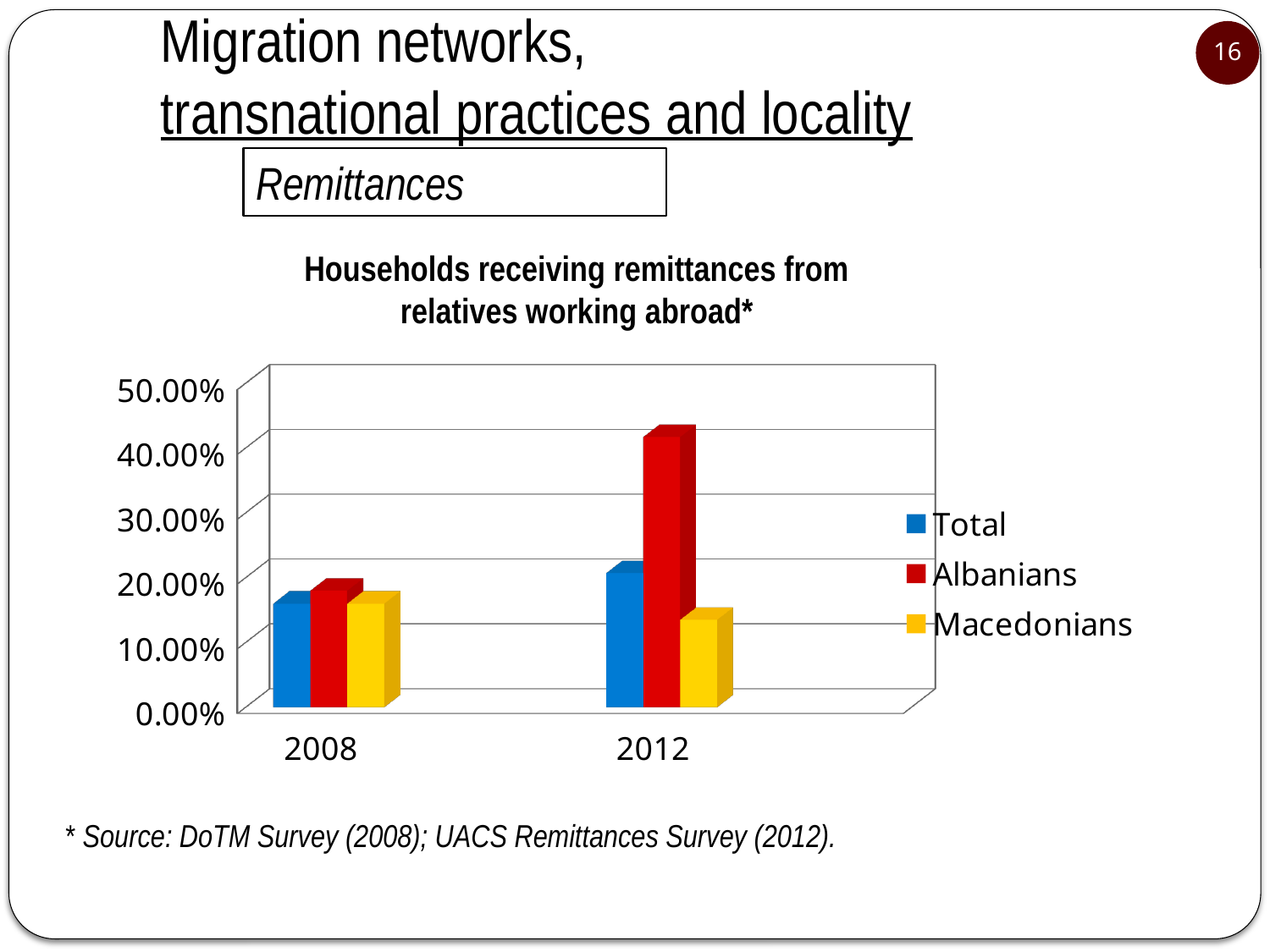
Does the value for Total rise or fall from 2008 to 2012? rise How many series does the legend list? 3 Is the value for Macedonians in 2012 greater or less than 20.00%? less Which series has the highest value in 2012? Albanians Is the value for Total in 2008 greater or less than 20.00%? less How many year categories are shown on the x axis? 2 What is the title of the chart? Households receiving remittances from relatives working abroad* Which is larger: the value for Albanians in 2008 or in 2012? 2012 Is the value for Albanians in 2008 greater or less than 30.00%? less Which series has the lowest value in 2012? Macedonians What kind of chart is shown on the slide? bar chart